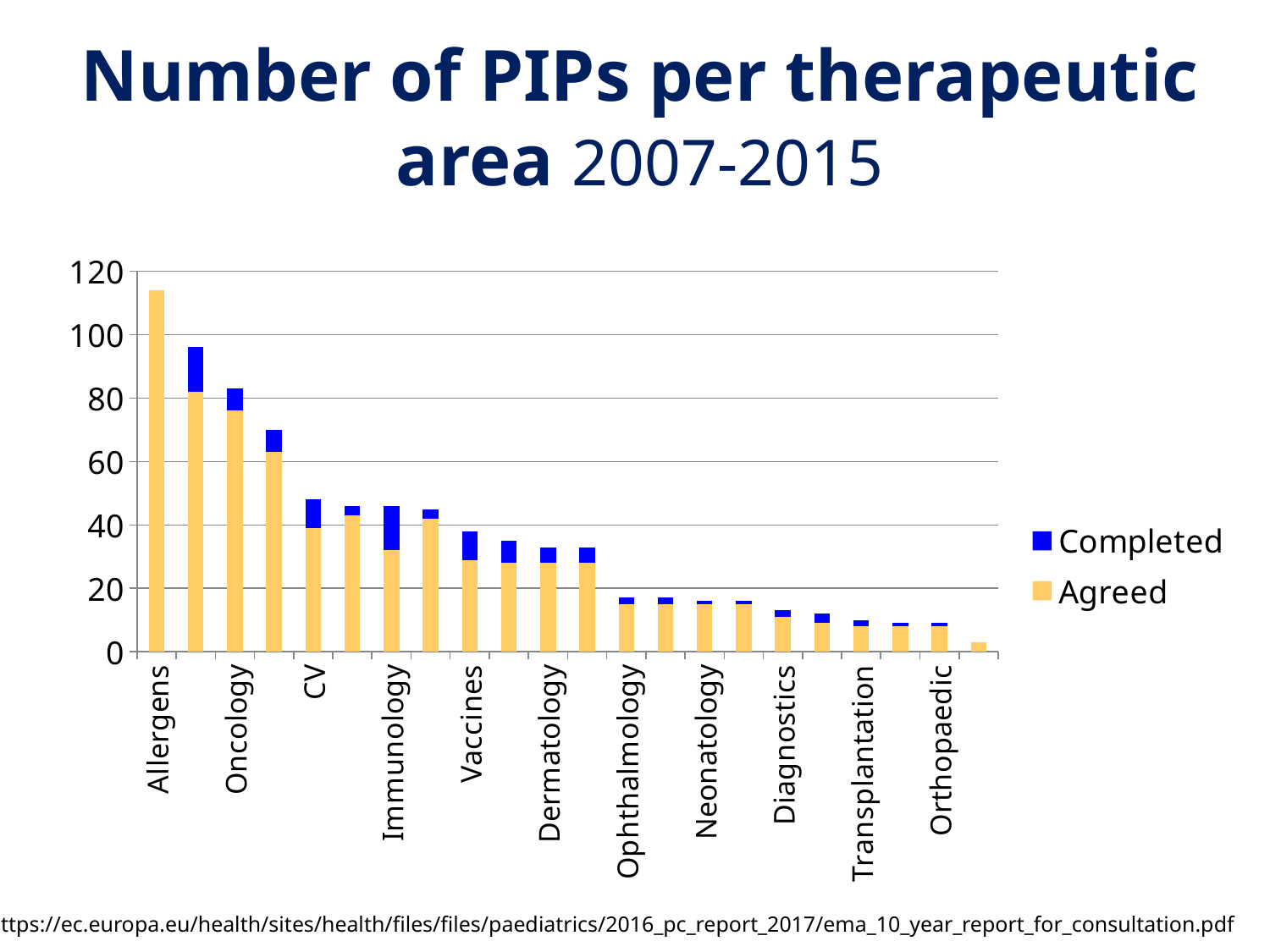
How many series does the legend list? 2 What are the two series named in the legend? Completed and Agreed Which has a larger total, Allergens or Oncology? Allergens Which therapeutic area has the tallest bar? Allergens Is the total value for Allergens greater or less than 100? greater Do the bar totals rise or fall moving from left to right along the x axis? Fall What kind of chart is shown on the slide? Stacked bar chart How many bars are plotted in the chart? 22 Is the total value for Dermatology greater or less than 40? less Is the total value for CV greater or less than 60? less